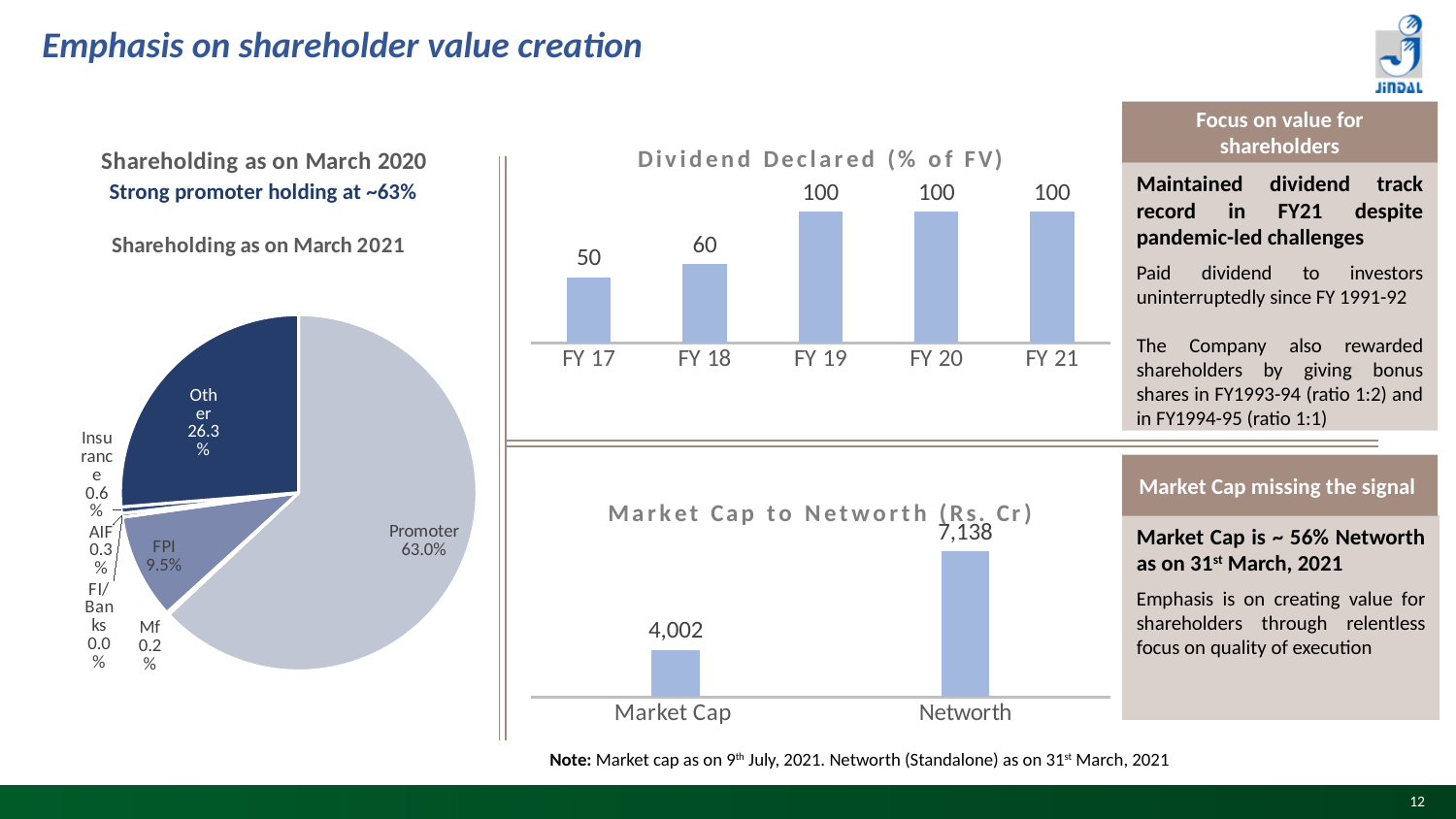
In the Shareholding as on March 2021 pie chart, which is larger, FPI or Other? Other In the Dividend Declared (% of FV) chart, which fiscal year has the lowest dividend declared? FY 17 In the Market Cap to Networth (Rs. Cr) chart, what is the difference between Networth and Market Cap? 3,136 In the Shareholding as on March 2021 pie chart, what share does Promoter hold? 63.0% What kind of chart is the Market Cap to Networth (Rs. Cr) chart? bar chart In the Market Cap to Networth (Rs. Cr) chart, what is the value for Networth? 7,138 In the Dividend Declared (% of FV) chart, what is the value for FY 17? 50 In the Dividend Declared (% of FV) chart, what is the difference between the FY 19 and FY 18 values? 40 In the Dividend Declared (% of FV) chart, do the values rise or fall from FY 17 to FY 21? rise How many fiscal years are shown in the Dividend Declared (% of FV) chart? 5 In the Dividend Declared (% of FV) chart, what is the value for FY 18? 60 In the Market Cap to Networth (Rs. Cr) chart, what is the value for Market Cap? 4,002